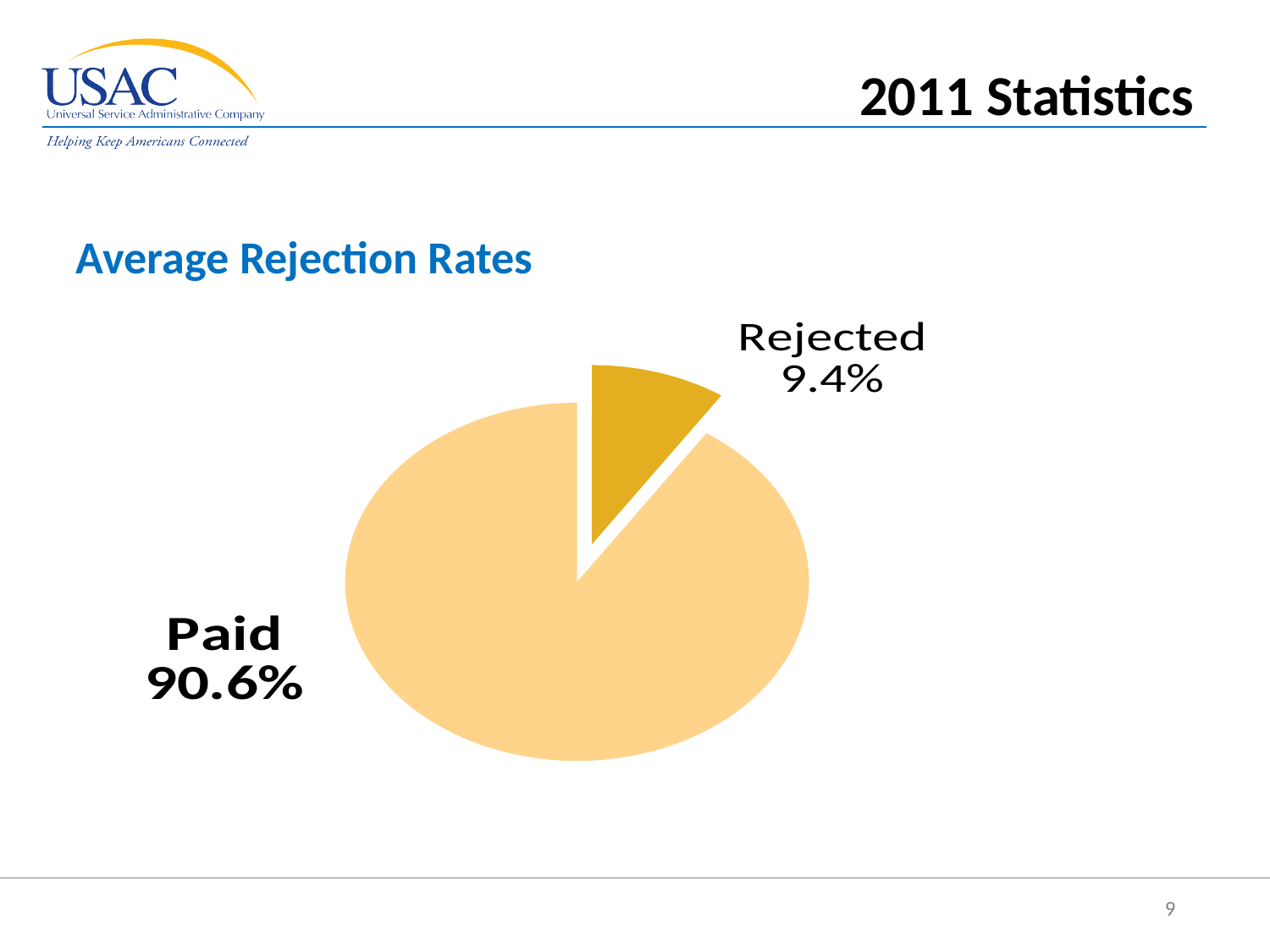
Which slice of the pie is the smallest? Rejected Which slice is pulled out (exploded) from the pie? Rejected What percentage of the pie is labelled Rejected? 9.4% What is the title of the chart on the slide? Average Rejection Rates Which is larger, the Paid slice or the Rejected slice? Paid What percentage of the pie is labelled Paid? 90.6% What is the difference in percentage points between the Paid and Rejected slices? 81.2 What type of chart is shown on the slide? pie chart Which slice of the pie is the largest? Paid What share of the pie does the Rejected slice represent? 9.4% How many slices does the pie chart have? 2